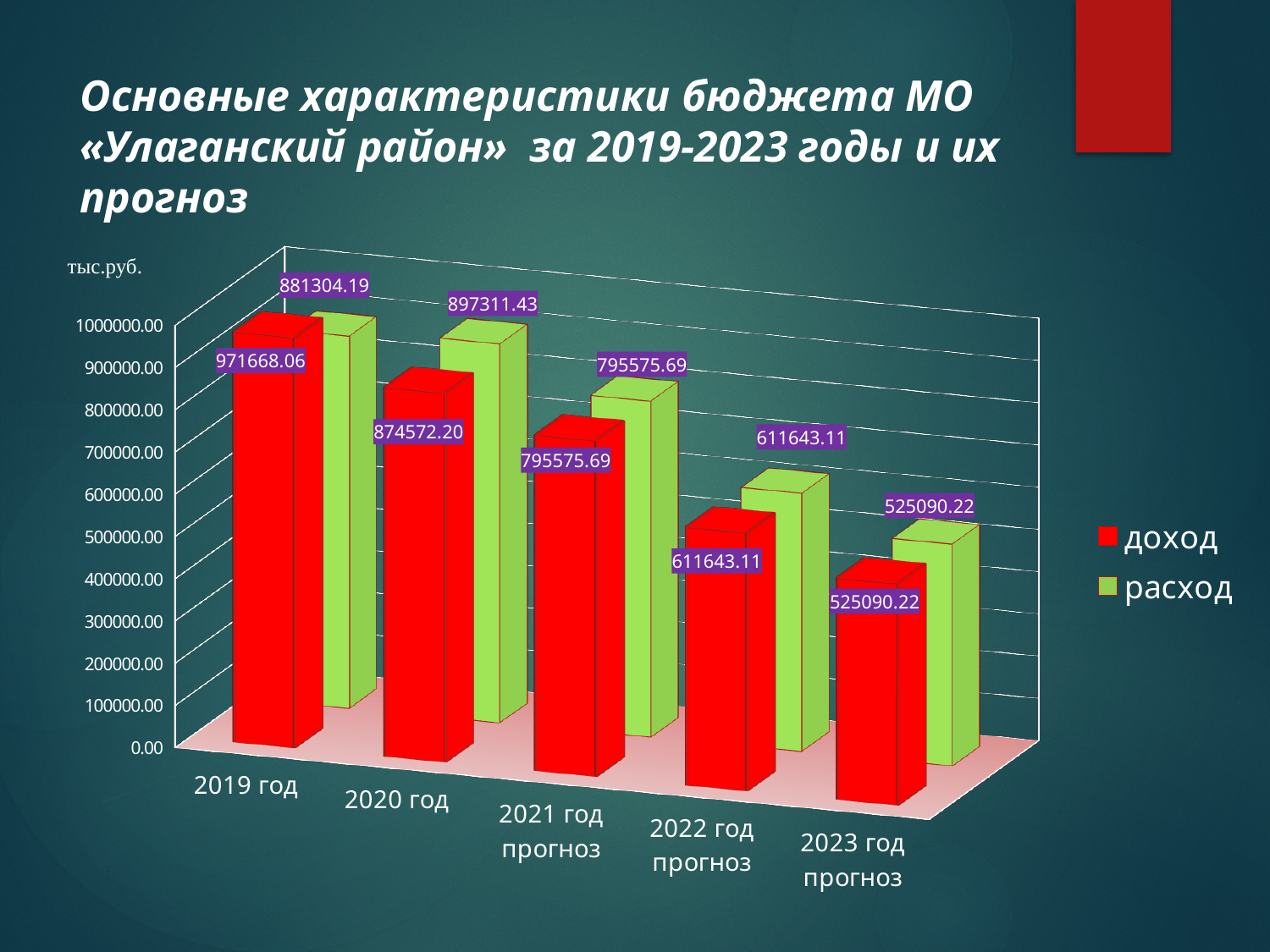
What is the value of доход for 2019 год? 971668.06 Which year has the lowest расход value? 2023 год прогноз How many year categories are shown on the x axis? 5 How many series does the legend list? 2 What is the value of доход for 2023 год прогноз? 525090.22 What is the value of расход for 2020 год? 897311.43 Which is larger for 2020 год, доход or расход? расход Which year has the highest доход value? 2019 год What kind of chart is shown on the slide? bar chart What is the value of расход for 2022 год прогноз? 611643.11 Do the доход values rise or fall from 2019 год to 2023 год прогноз? fall What is the difference between доход and расход for 2019 год? 90363.87